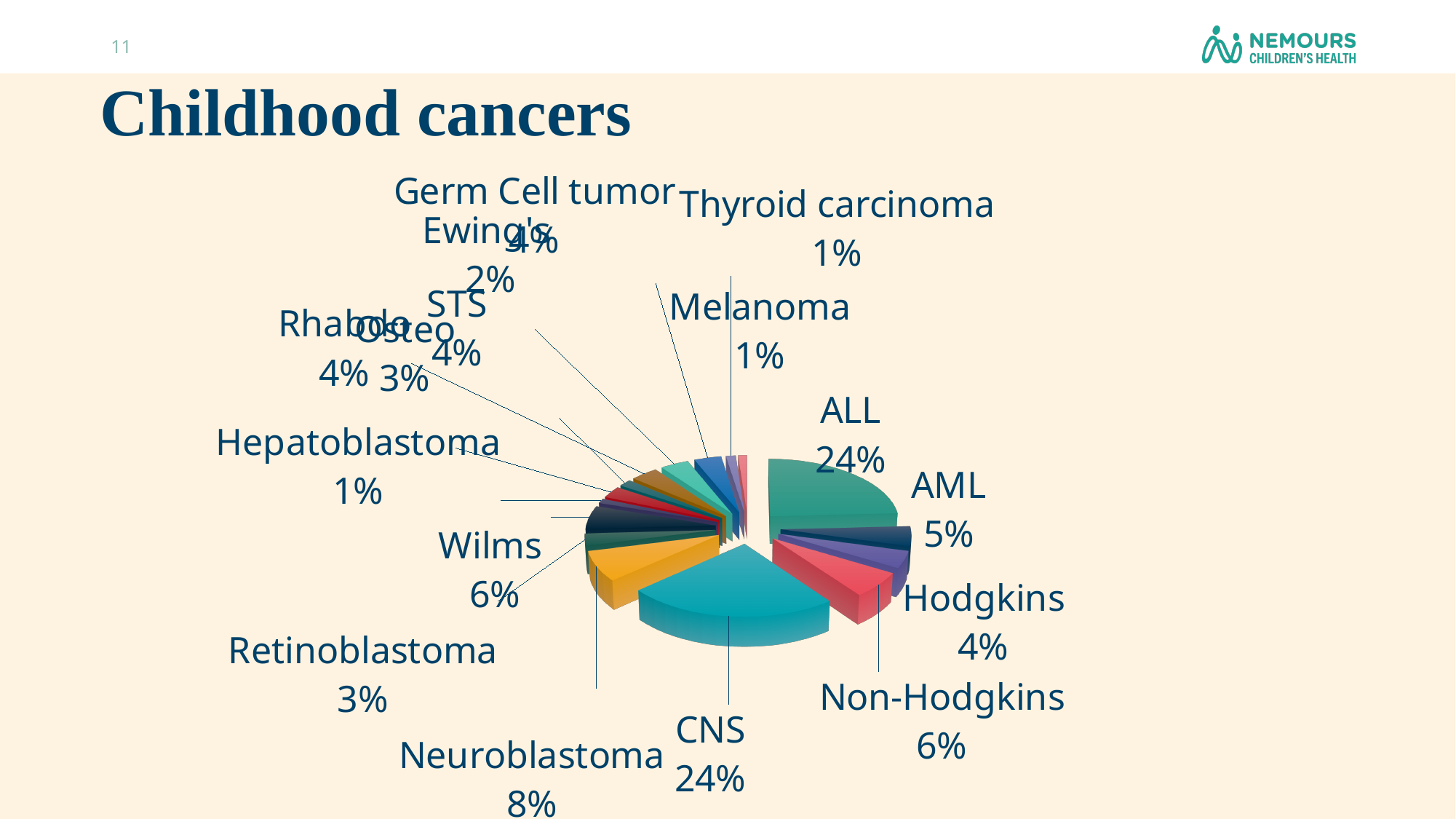
Which is larger, the share for Hodgkins or the share for Non-Hodgkins? Non-Hodgkins Which is larger, the share for Neuroblastoma or the share for Wilms? Neuroblastoma What is the difference between the ALL share and the AML share? 19 percentage points What is the value shown for Hepatoblastoma? 1% What percentage does the CNS slice represent? 24% What percentage does the ALL slice represent? 24% What is the value shown for Non-Hodgkins? 6% What is the value shown for Retinoblastoma? 3% What is the value shown for AML? 5% What is the value shown for Neuroblastoma? 8% What is the title of the slide containing the chart? Childhood cancers What kind of chart is shown on the slide? pie chart